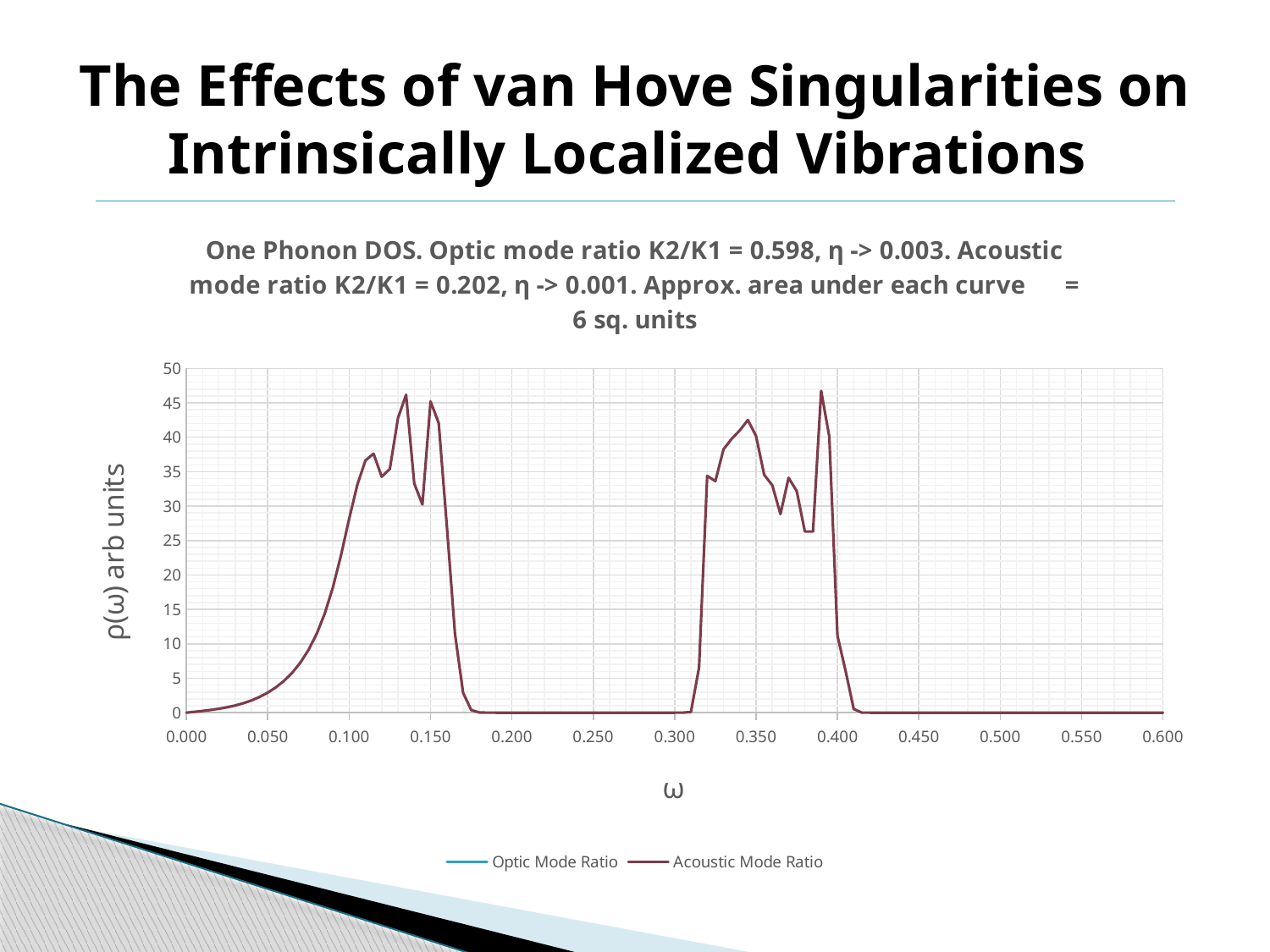
What is the value of the curve at ω = 0.250? 0 What is the value of the curve at ω = 0.500? 0 Is the value of the curve at ω = 0.350 greater or less than 30? greater What kind of chart is shown on the slide? line chart Is the value of the curve at ω = 0.100 greater or less than 20? greater Is the value of the curve at ω = 0.400 greater or less than 20? less What are the two series named in the legend? Optic Mode Ratio and Acoustic Mode Ratio How many series does the legend list? 2 What is the label on the y axis? ρ(ω) arb units Do the values rise or fall as ω increases from 0.050 to 0.100? rise Which is larger, the value of the curve at ω = 0.100 or at ω = 0.250? ω = 0.100